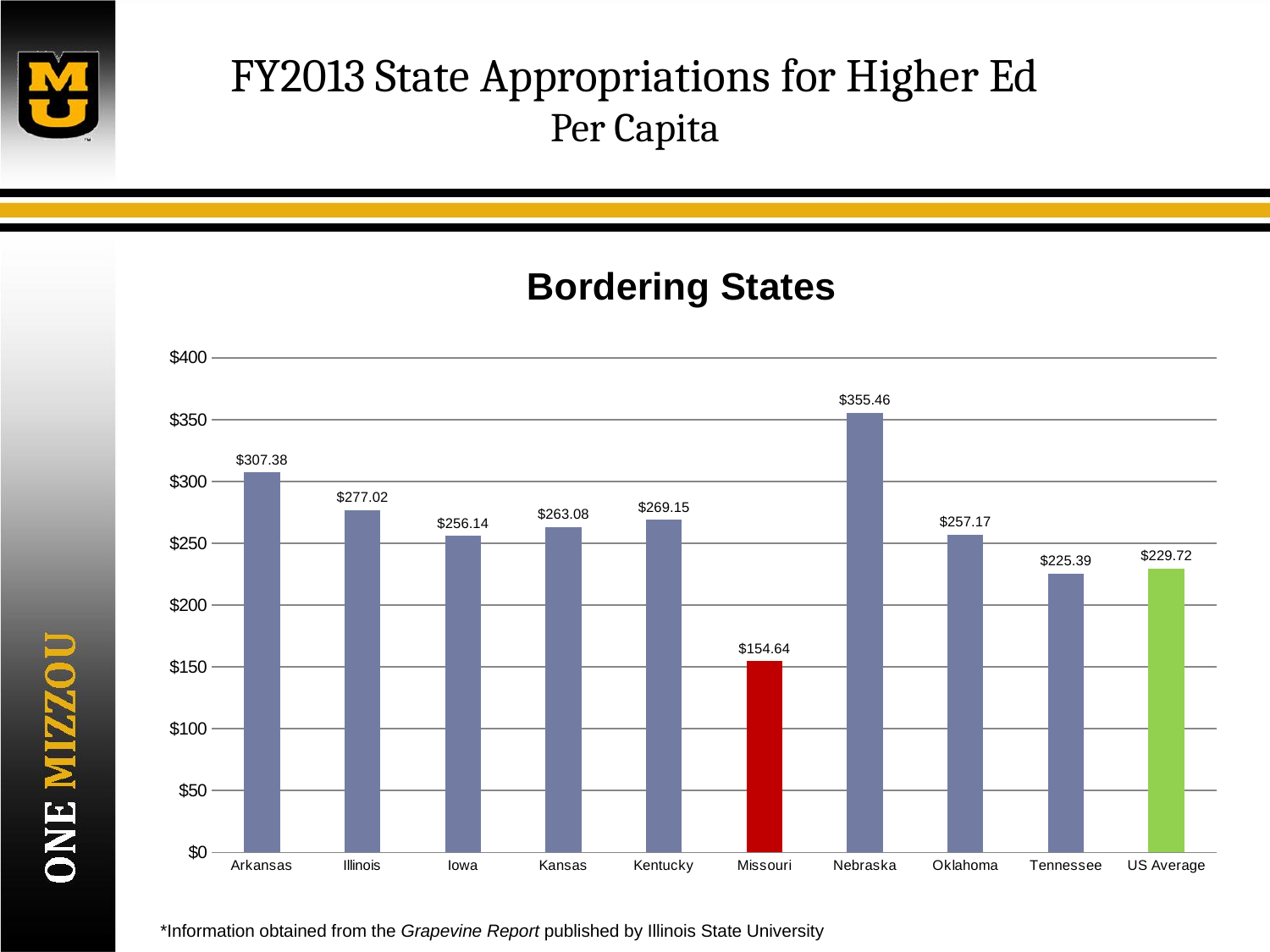
What is the difference between the US Average and Missouri's value? $75.08 What is the difference between Nebraska's and Missouri's per capita appropriations? $200.82 What is the title of the chart? Bordering States Which is larger, the value for Kansas or the value for Kentucky? Kentucky What is the per capita state appropriation for Missouri? $154.64 Which category has the lowest per capita appropriation? Missouri What is the per capita state appropriation for Nebraska? $355.46 How many categories are shown on the x axis? 10 Is the value for Arkansas greater or less than $300? greater Which state has the highest per capita appropriation? Nebraska What kind of chart is this? Bar chart What is the value shown for the US Average? $229.72